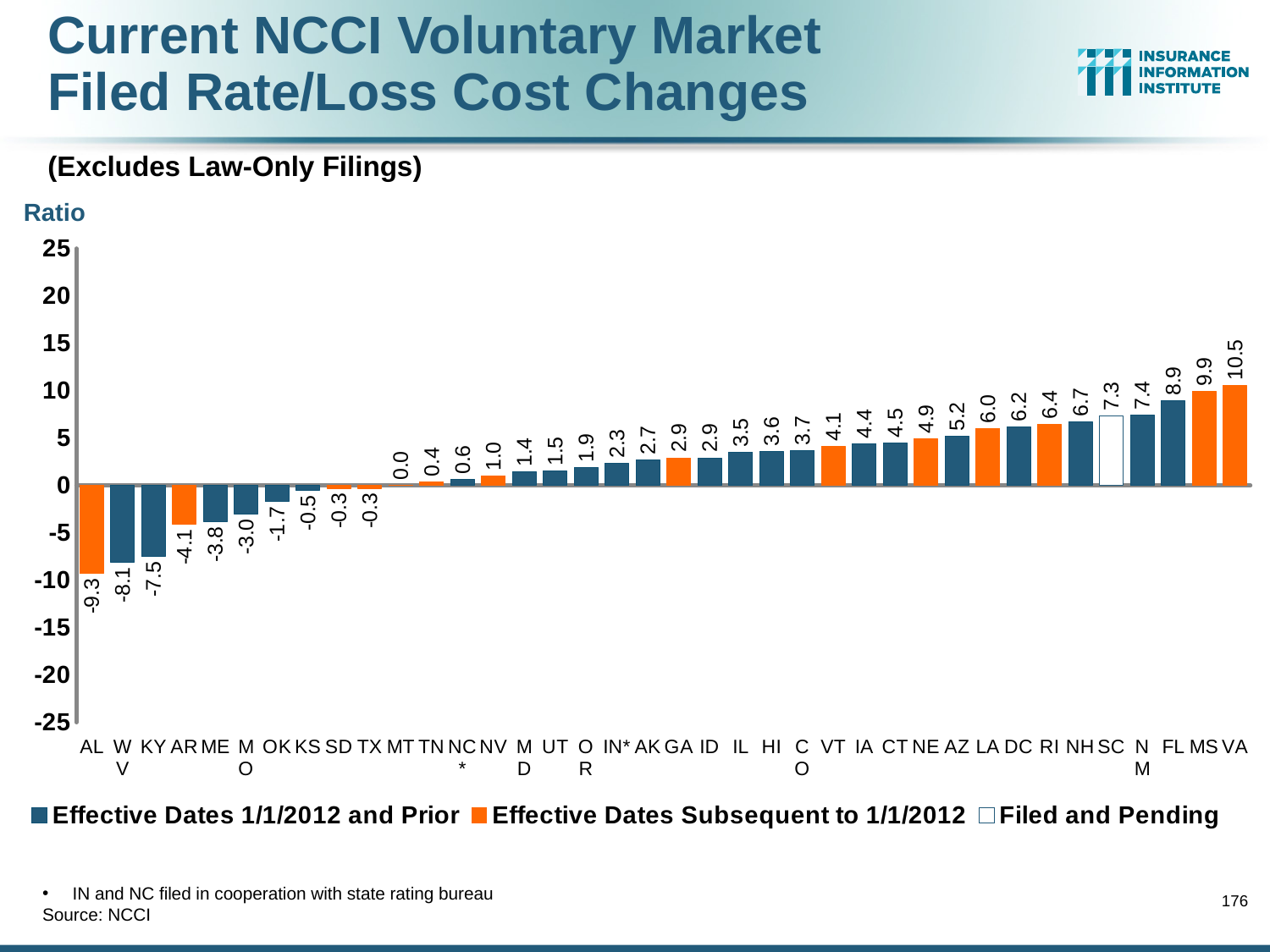
What kind of chart is this? Bar chart What is the value for VA? 10.5 How many series does the legend list? 3 Which is larger, the value for KY or the value for WV? KY What is the difference between the values for MS and FL? 1.0 What is the value for SC? 7.3 Which state has the highest value? VA What is the difference between the values for VA and AL? 19.8 Which state has the lowest value? AL How many states are shown on the x axis? 38 Which state is shown as Filed and Pending? SC What is the value for AL? -9.3